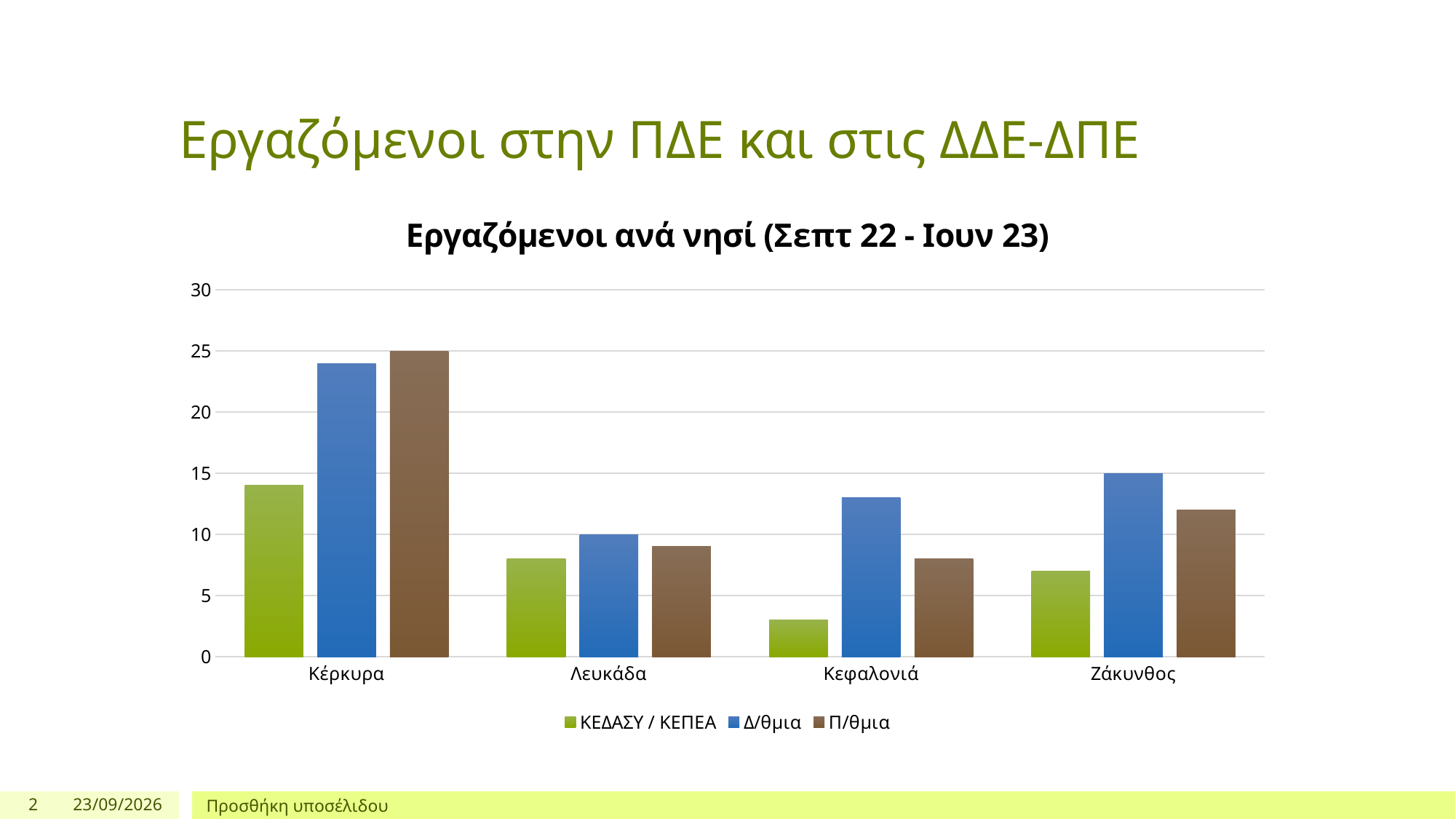
What is the value for Δ/θμια in Λευκάδα? 10 How many series does the legend list? 3 What is the title of the chart? Εργαζόμενοι ανά νησί (Σεπτ 22 - Ιουν 23) Which island has the lowest value for ΚΕΔΑΣΥ / ΚΕΠΕΑ? Κεφαλονιά Which island has the highest value for ΚΕΔΑΣΥ / ΚΕΠΕΑ? Κέρκυρα What kind of chart is shown on the slide? bar chart Is the value for Δ/θμια in Κεφαλονιά greater or less than 10? greater Is the value for ΚΕΔΑΣΥ / ΚΕΠΕΑ in Κεφαλονιά greater or less than 5? less In Ζάκυνθος, which is larger: the value for Δ/θμια or the value for Π/θμια? Δ/θμια How many islands (categories) are shown on the x axis? 4 What is the value for Δ/θμια in Ζάκυνθος? 15 What is the value for Π/θμια in Κέρκυρα? 25